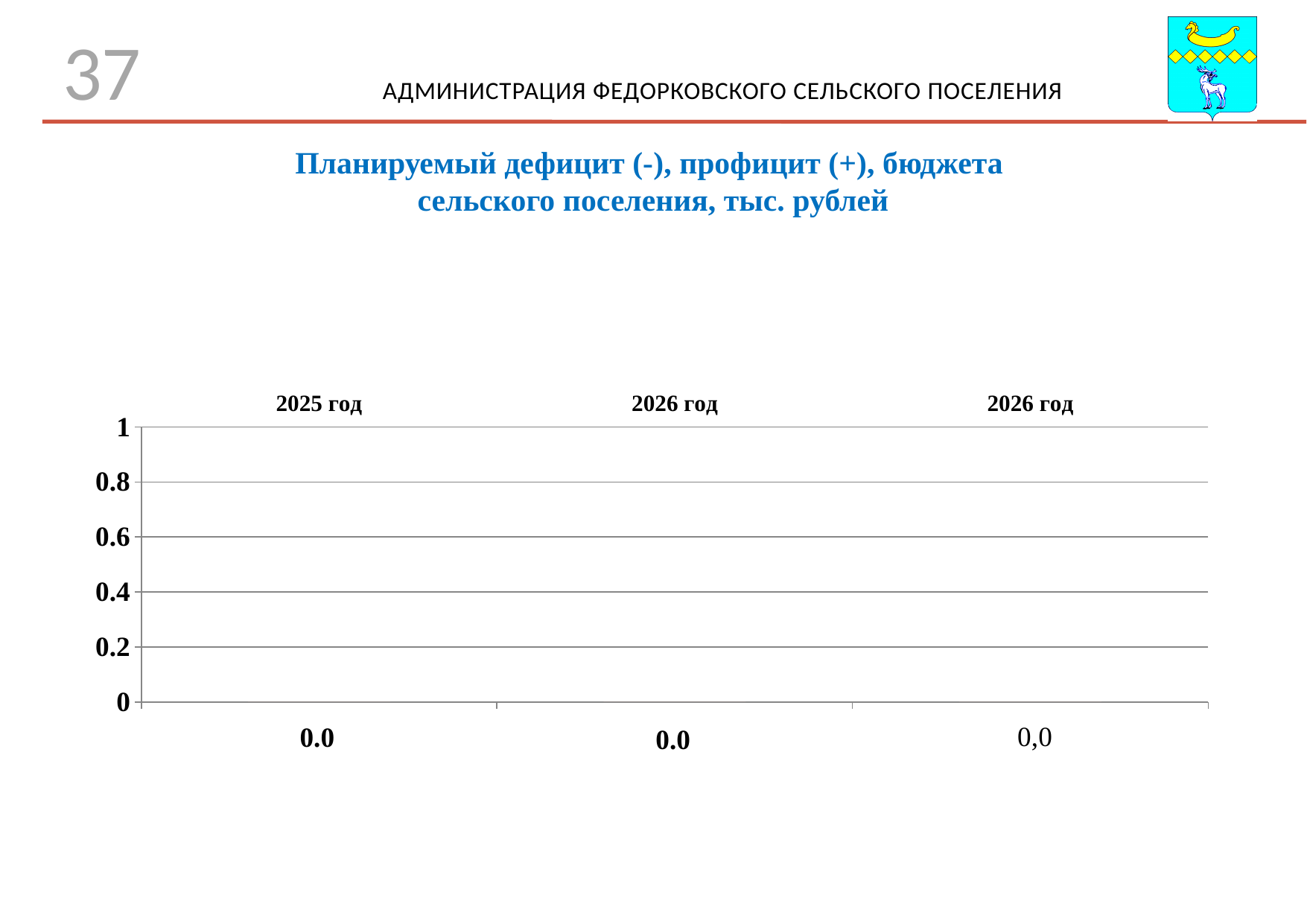
What is the value shown for the rightmost category on the chart? 0,0 Do the values rise, fall, or stay the same across the categories from left to right? stay the same What is the highest tick value shown on the vertical axis? 1 What is the difference between the value for 2025 год and the value for the middle 2026 год category? 0.0 What is the title of the chart? Планируемый дефицит (-), профицит (+), бюджета сельского поселения, тыс. рублей What is the value shown for the middle category, 2026 год? 0.0 Is the value for 2025 год greater or less than 0.2? less What is the value shown for 2025 год? 0.0 How many categories are shown along the x axis of the chart? 3